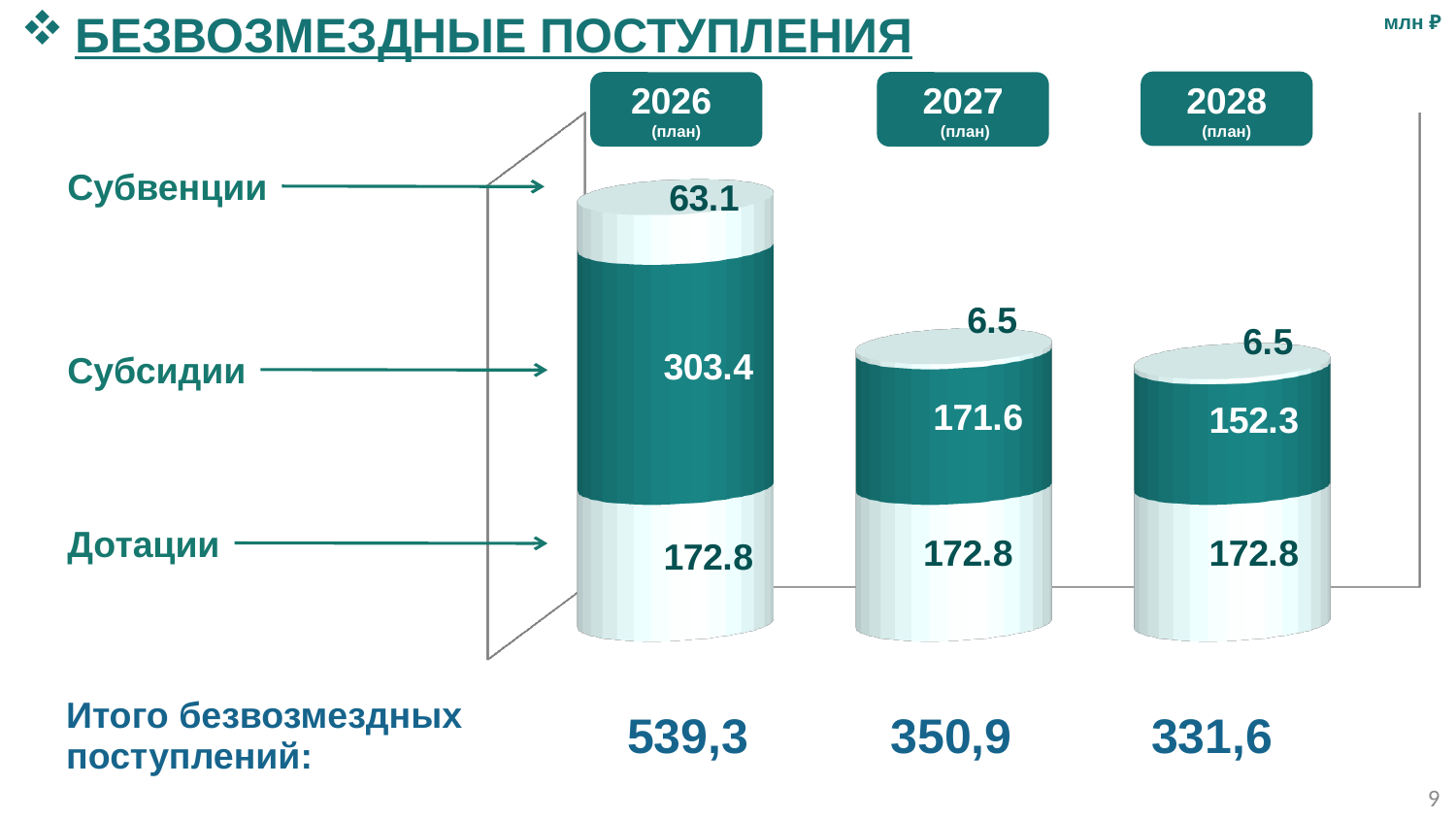
Which year has the lowest value for Субсидии? 2028 What is the total of the stacked bar for 2027 (план)? 350,9 Which is larger in 2027: Субсидии or Дотации? Дотации What is the value for Дотации in 2028 (план)? 172.8 What is the value for Субсидии in 2028 (план)? 152.3 What is the difference between the Субсидии values for 2026 and 2027? 131.8 How many years are shown in the chart? 3 What is the value for Субвенции in 2027 (план)? 6.5 What is the value for Субсидии in 2026 (план)? 303.4 Which year has the highest value for Субсидии? 2026 Do the Субсидии values rise or fall from 2026 to 2028? fall How many series (categories of receipts) are shown in the chart? 3